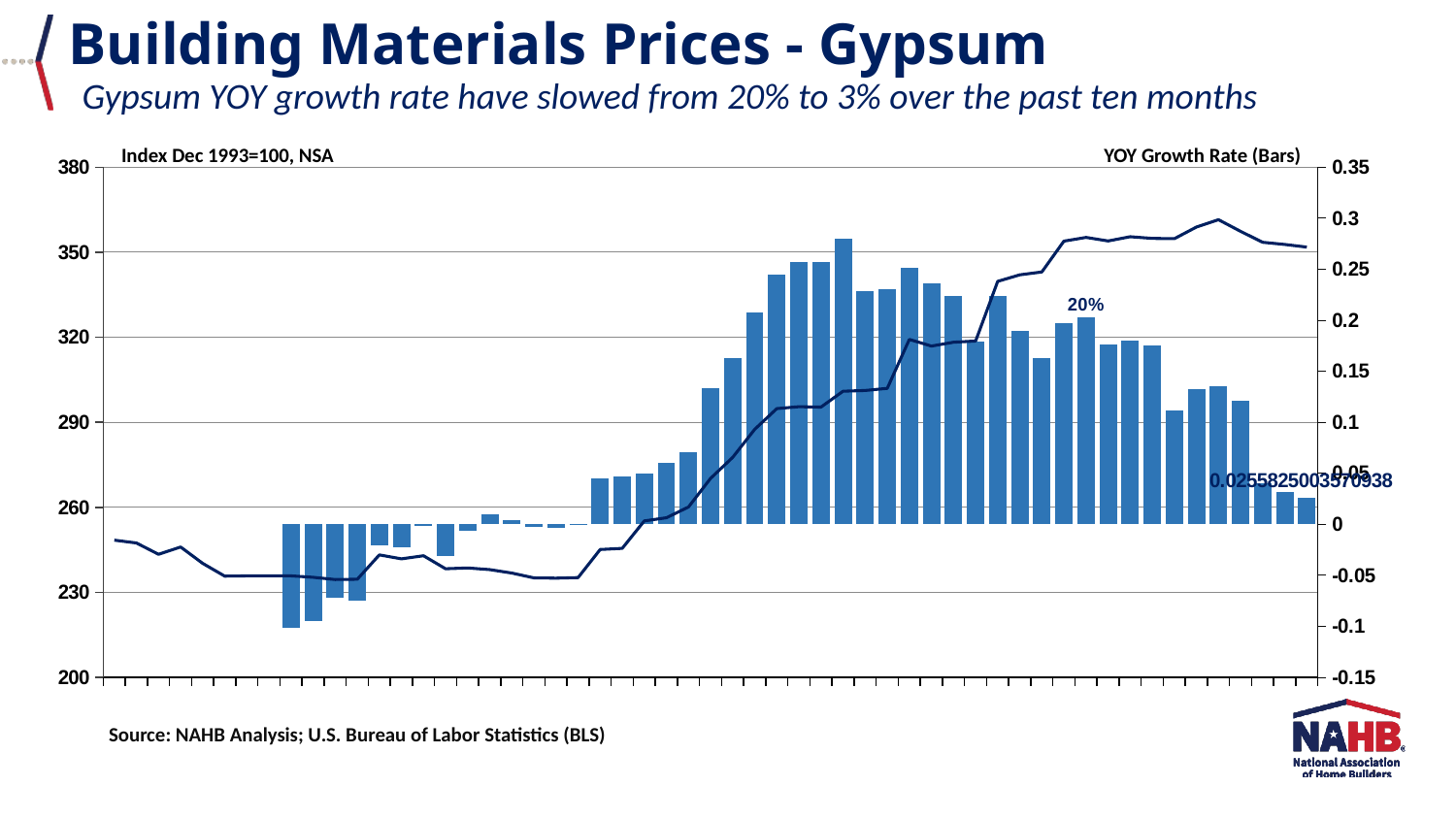
What percentage label is printed above one of the bars in the right half of the chart? 20% What value is printed as the data label on the last (rightmost) bar? 0.0255825003570938 Is the value of the last (rightmost) bar greater or less than 0.05? less Does the index line generally rise or fall from the left of the chart to the right? rise What kind of chart is shown on the slide? A combination chart with bars and a line Is the value of the lowest (most negative) bar greater or less than -0.05? less What is the highest tick value shown on the right-hand axis? 0.35 Is the value of the tallest bar greater or less than 0.25? greater What label is shown at the top of the right-hand axis? YOY Growth Rate (Bars) What label is shown at the top of the left-hand axis? Index Dec 1993=100, NSA